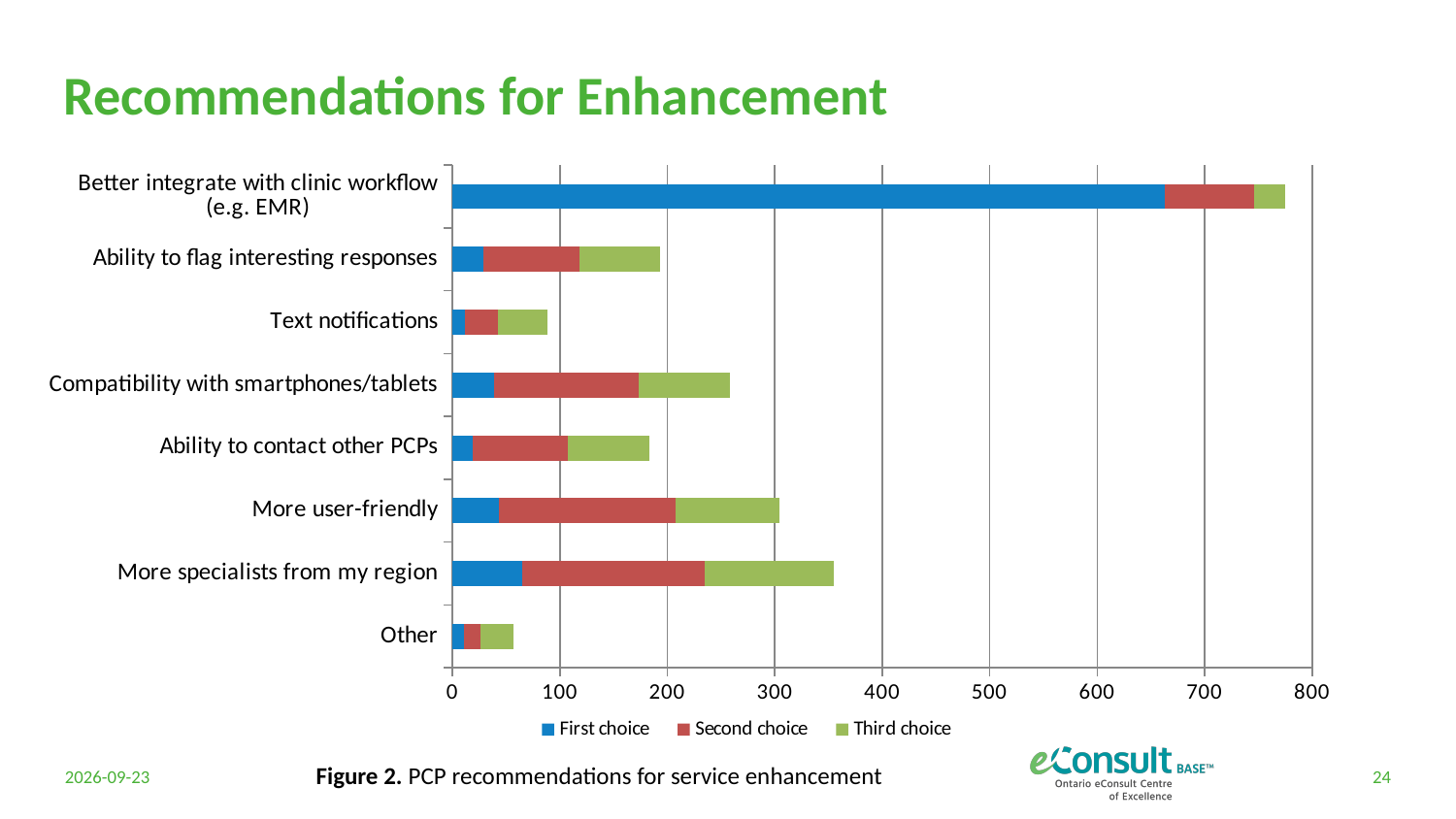
What colour represents the 'First choice' series in the chart? Blue Which has the longer total bar: 'More specialists from my region' or 'More user-friendly'? More specialists from my region Is the total bar for 'Text notifications' greater or less than 100? less How many series does the legend list? 3 Which category has the shortest total bar? Other How many categories are plotted on the chart? 8 Is the total bar for 'Better integrate with clinic workflow (e.g. EMR)' greater or less than 700? greater Which category has the longest total bar? Better integrate with clinic workflow (e.g. EMR) Is the total bar for 'More specialists from my region' greater or less than 300? greater Which has the longer total bar: 'Compatibility with smartphones/tablets' or 'Ability to contact other PCPs'? Compatibility with smartphones/tablets What kind of chart is shown on the slide? Stacked bar chart